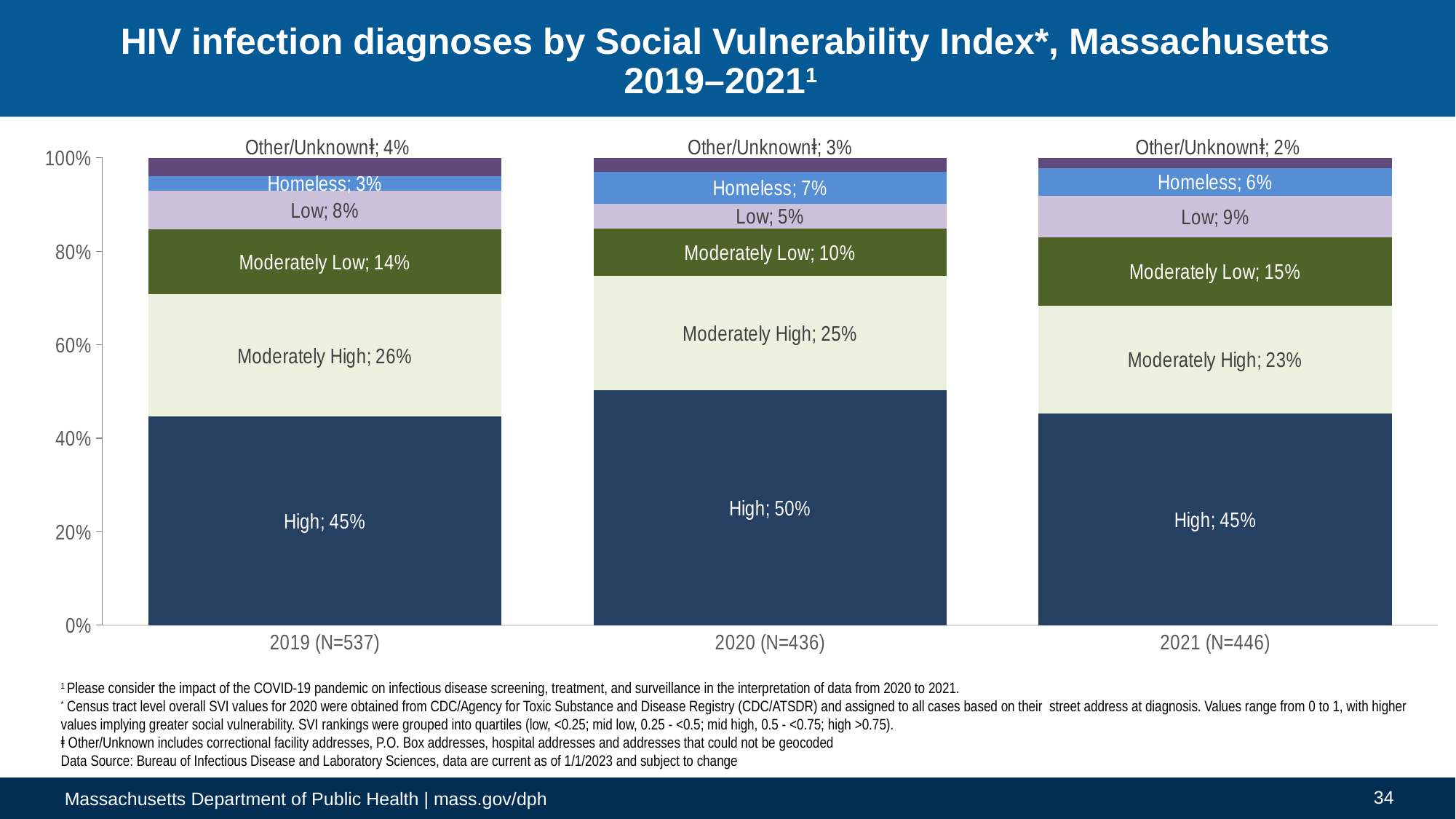
By how many percentage points did the Moderately High share change from 2019 to 2021? 3 percentage points What is the total number of diagnoses (N) for 2020 shown on the x axis? 436 What kind of chart is shown on the slide? Stacked bar chart What percentage of HIV infection diagnoses in 2020 were in the High SVI category? 50% Does the Other/Unknown share rise or fall from 2019 to 2021? Fall What was the Moderately Low share in 2019? 14% In which year was the Other/Unknown share the smallest? 2021 How many years (bars) are shown in the chart? 3 In which year was the High SVI share the largest? 2020 What percentage of diagnoses in 2021 fell in the Low SVI category? 9% What share of diagnoses in 2020 were among people who were Homeless? 7% Which year had a larger Low SVI share, 2019 or 2020? 2019